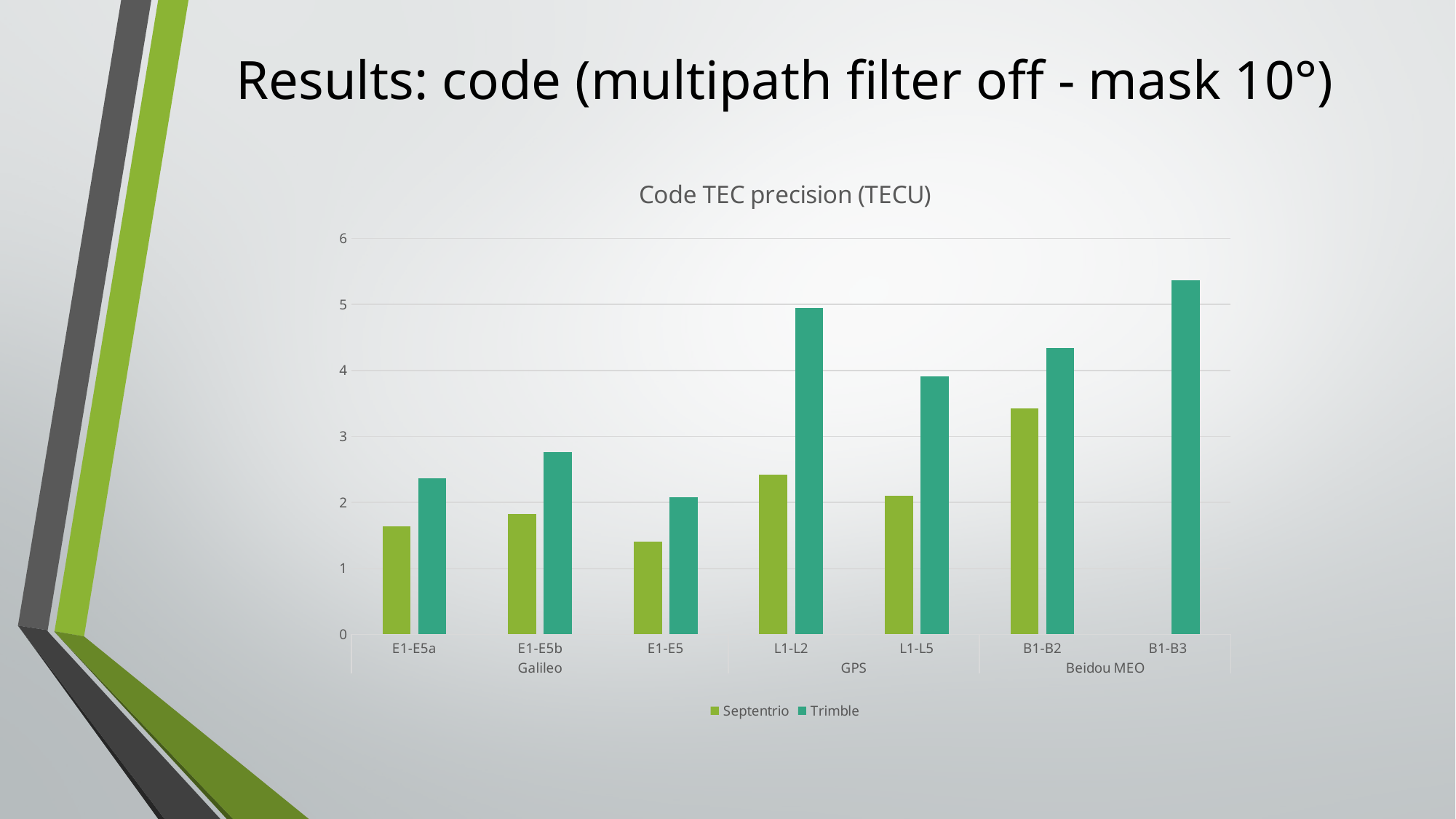
Is the Septentrio value for E1-E5a greater or less than 2? less Is the Trimble value for L1-L2 greater or less than 4? greater How many series does the legend list? 2 Which category has the highest Septentrio value? B1-B2 Is the Trimble value for B1-B3 greater or less than 5? greater Which category has the highest Trimble value? B1-B3 Which category has the lowest Septentrio value? E1-E5 What is the title of the chart? Code TEC precision (TECU) What kind of chart is shown on the slide? bar chart How many signal categories are shown along the x axis? 7 For L1-L5, which is larger: the Septentrio value or the Trimble value? Trimble Which category has the lowest Trimble value? E1-E5